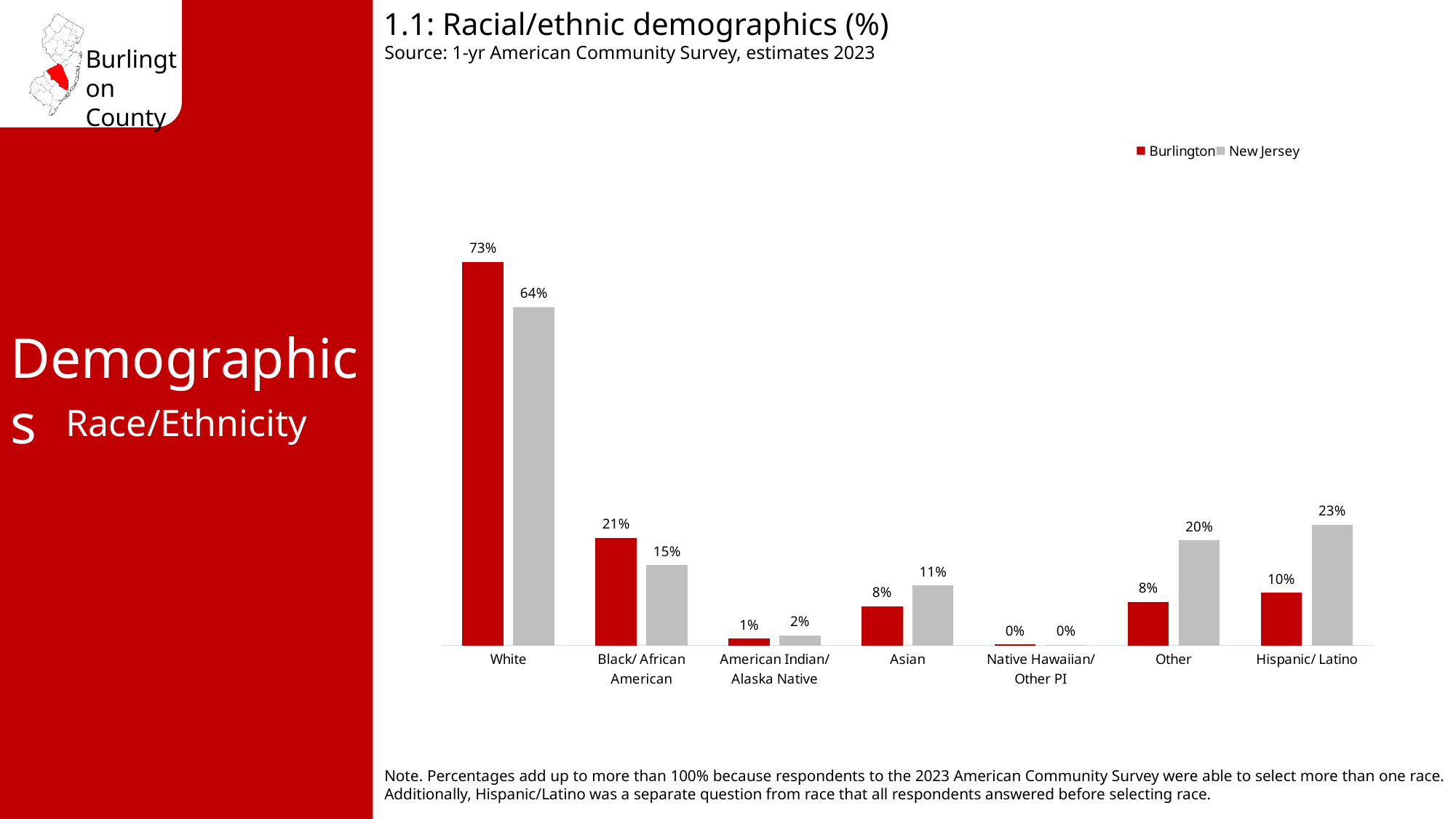
What is the Burlington value for White? 73% Which category has the highest Burlington value? White What is the Burlington value for Black/ African American? 21% Which category has the lowest New Jersey value? Native Hawaiian/ Other PI What is the difference between the Burlington and New Jersey values for White? 9% What kind of chart is shown on the slide? Bar chart How many series does the legend list? 2 What is the New Jersey value for Hispanic/ Latino? 23% What is the New Jersey value for Asian? 11% Which is larger for Hispanic/ Latino, the Burlington value or the New Jersey value? New Jersey How many categories are shown on the x axis? 7 What is the difference between the New Jersey and Burlington values for Other? 12%